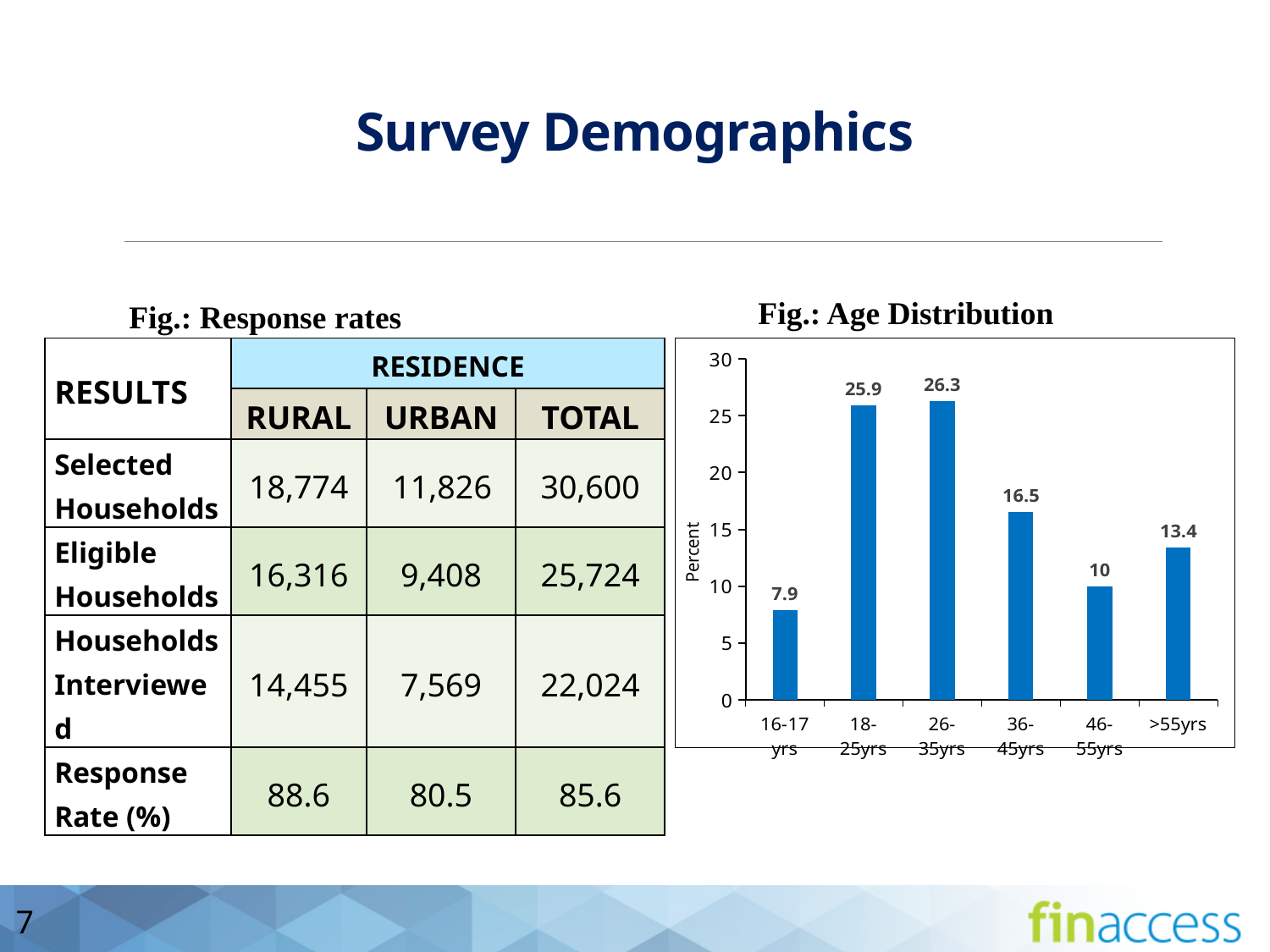
In the Age Distribution chart, what is the percent for the 36-45yrs group? 16.5 In the Age Distribution chart, what is the percent for the 46-55yrs group? 10 In the Age Distribution chart, what is the difference in percent between the 26-35yrs and 18-25yrs groups? 0.4 In the Age Distribution chart, what is the percent for the >55yrs group? 13.4 How many age groups are shown in the Age Distribution chart? 6 In the Age Distribution chart, which group has a larger percent, 36-45yrs or >55yrs? 36-45yrs What type of chart is the Age Distribution figure? Bar chart In the Age Distribution chart, what is the percent for the 16-17 yrs group? 7.9 In the Age Distribution chart, what is the difference in percent between the 36-45yrs and 46-55yrs groups? 6.5 In the Age Distribution chart, which age group has the highest percent? 26-35yrs What is the label of the vertical axis in the Age Distribution chart? Percent In the Age Distribution chart, which age group has the lowest percent? 16-17 yrs